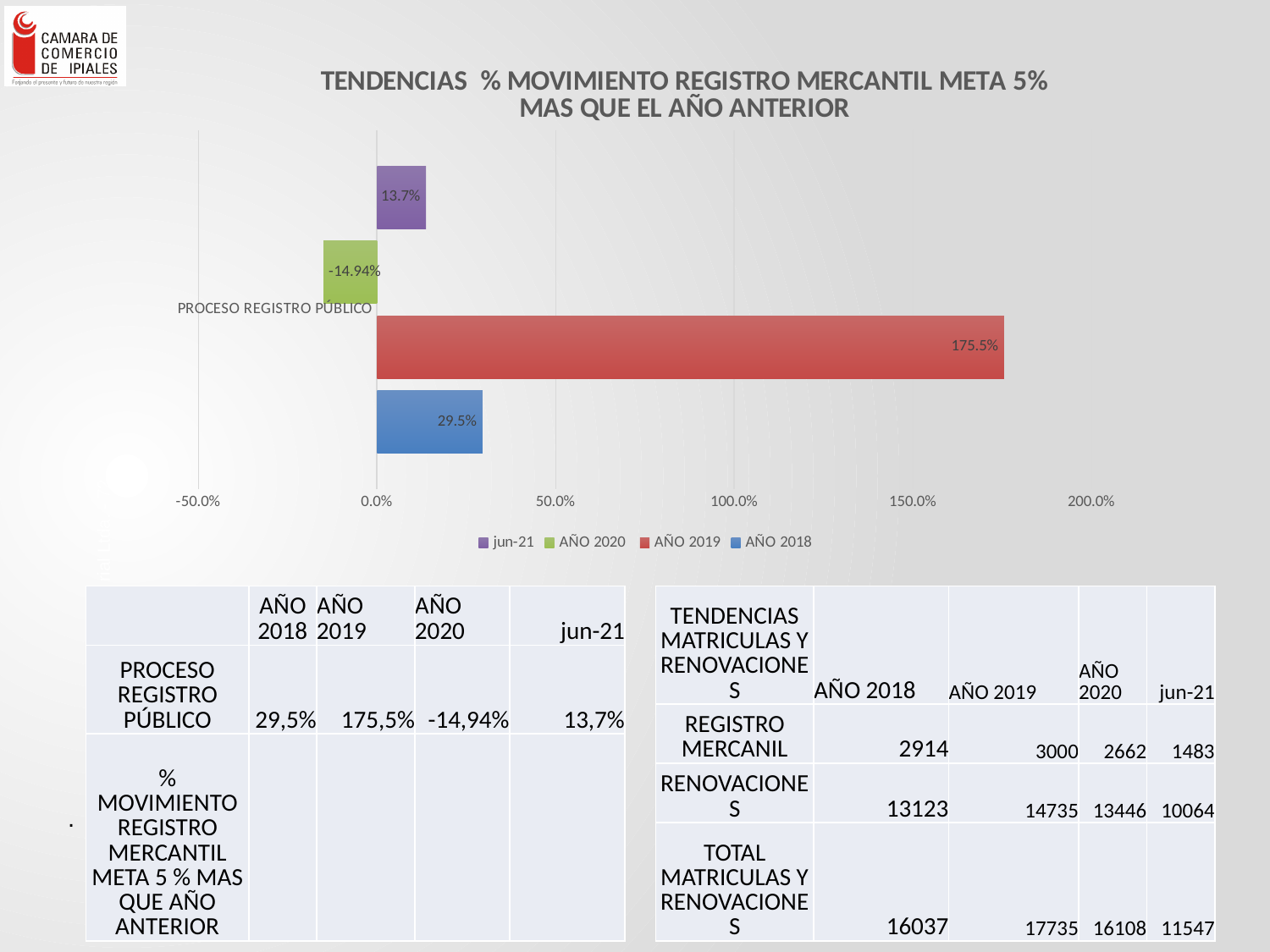
What type of chart is shown on the slide? bar chart What is the value for AÑO 2018 in the chart? 29.5% What is the value for jun-21 in the chart? 13.7% Which series has the lowest value in the chart? AÑO 2020 What is the value for AÑO 2020 in the chart? -14.94% Which is larger, the value for AÑO 2018 or the value for jun-21? AÑO 2018 What is the difference between the values for AÑO 2019 and AÑO 2018? 146.0% What category label is shown on the vertical axis of the chart? PROCESO REGISTRO PÚBLICO Is the value for AÑO 2019 greater or less than 150.0%? greater What is the value for AÑO 2019 in the chart? 175.5% Which series has the highest value in the chart? AÑO 2019 How many series does the chart legend list? 4